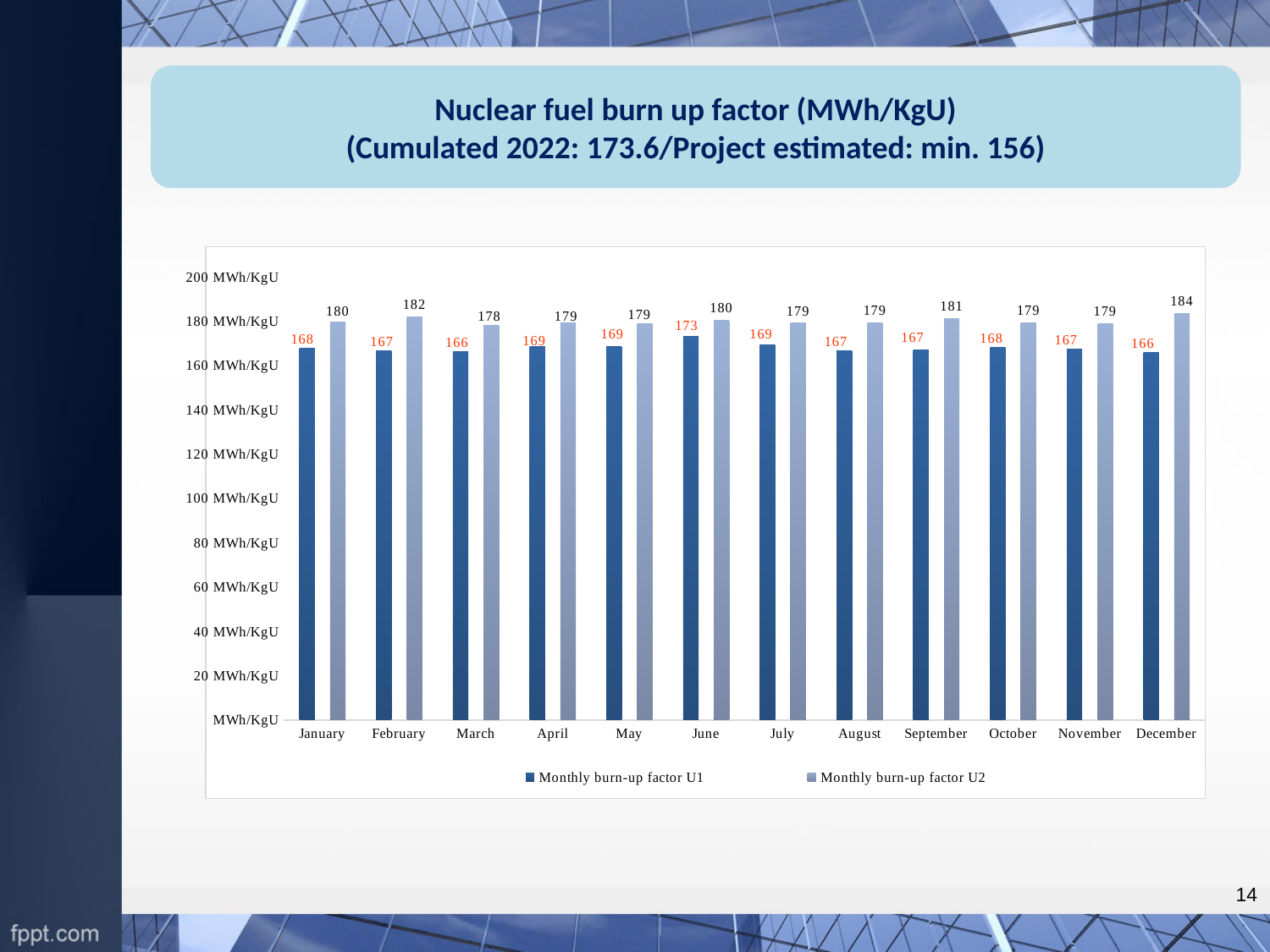
How many months are shown on the x axis? 12 What is the Monthly burn-up factor U2 value for December? 184 What is the Monthly burn-up factor U2 value for February? 182 Which month has the lowest Monthly burn-up factor U2? March How many series does the legend list? 2 What is the difference between the U2 and U1 burn-up factors in December? 18 Which month has the highest Monthly burn-up factor U2? December What kind of chart is shown on the slide? Bar chart What is the Monthly burn-up factor U1 value for October? 168 Which month has the highest Monthly burn-up factor U1? June Which is larger in September: the Monthly burn-up factor U1 or U2? Monthly burn-up factor U2 What is the Monthly burn-up factor U1 value for June? 173